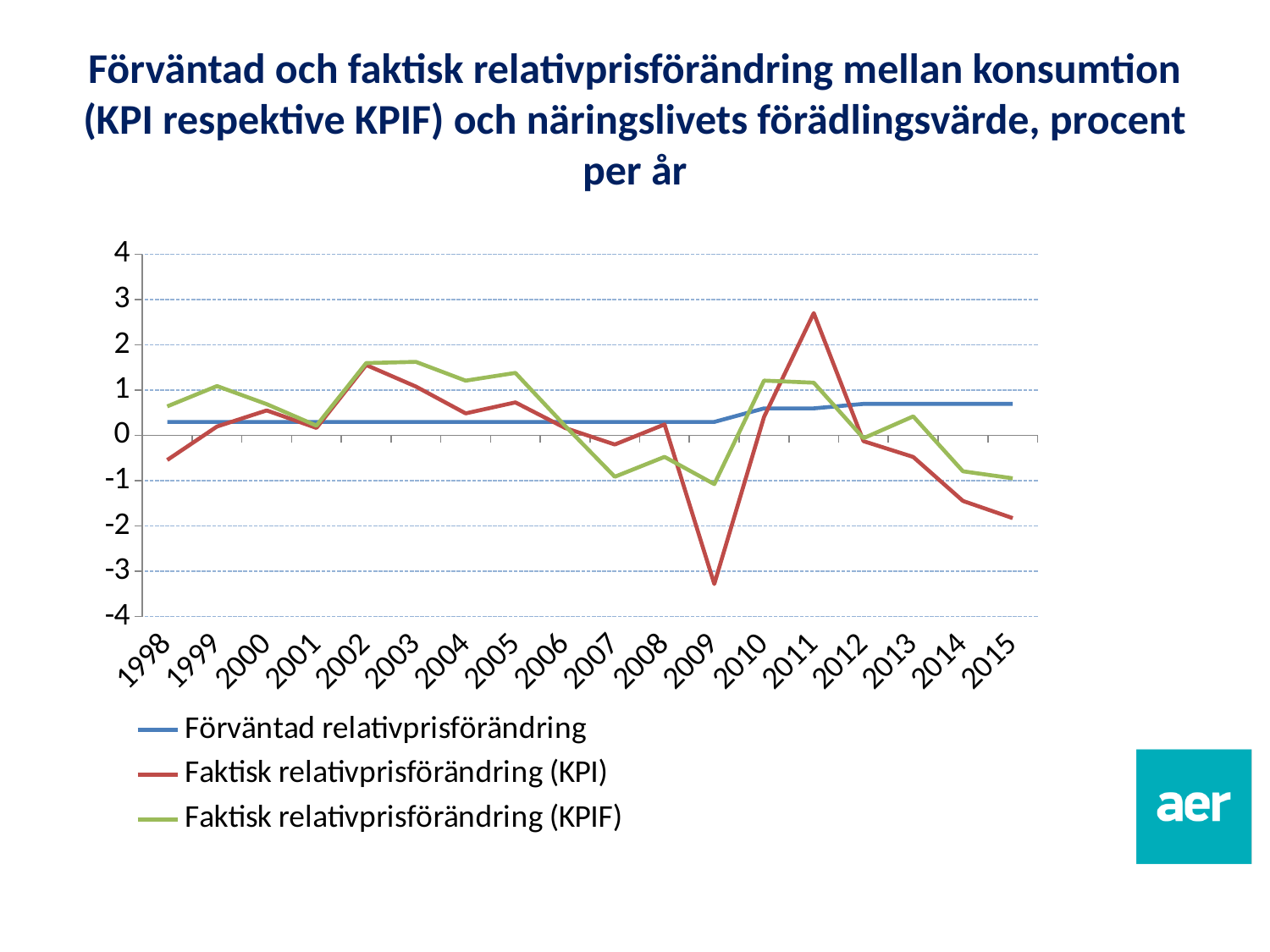
How many years are shown on the x axis? 18 In which year is Faktisk relativprisförändring (KPI) at its highest? 2011 Does Förväntad relativprisförändring rise or fall between 2008 and 2012? rise Is the value for Faktisk relativprisförändring (KPI) in 2009 greater or less than -3? less Is the value for Faktisk relativprisförändring (KPIF) in 2003 greater or less than 1? greater How many series does the legend list? 3 What kind of chart is shown on the slide? line chart In 2009, which is larger: Faktisk relativprisförändring (KPI) or Faktisk relativprisförändring (KPIF)? Faktisk relativprisförändring (KPIF) Is the value for Faktisk relativprisförändring (KPI) in 2015 greater or less than -1? less In 2011, which is larger: Faktisk relativprisförändring (KPI) or Faktisk relativprisförändring (KPIF)? Faktisk relativprisförändring (KPI) In which year is Faktisk relativprisförändring (KPI) at its lowest? 2009